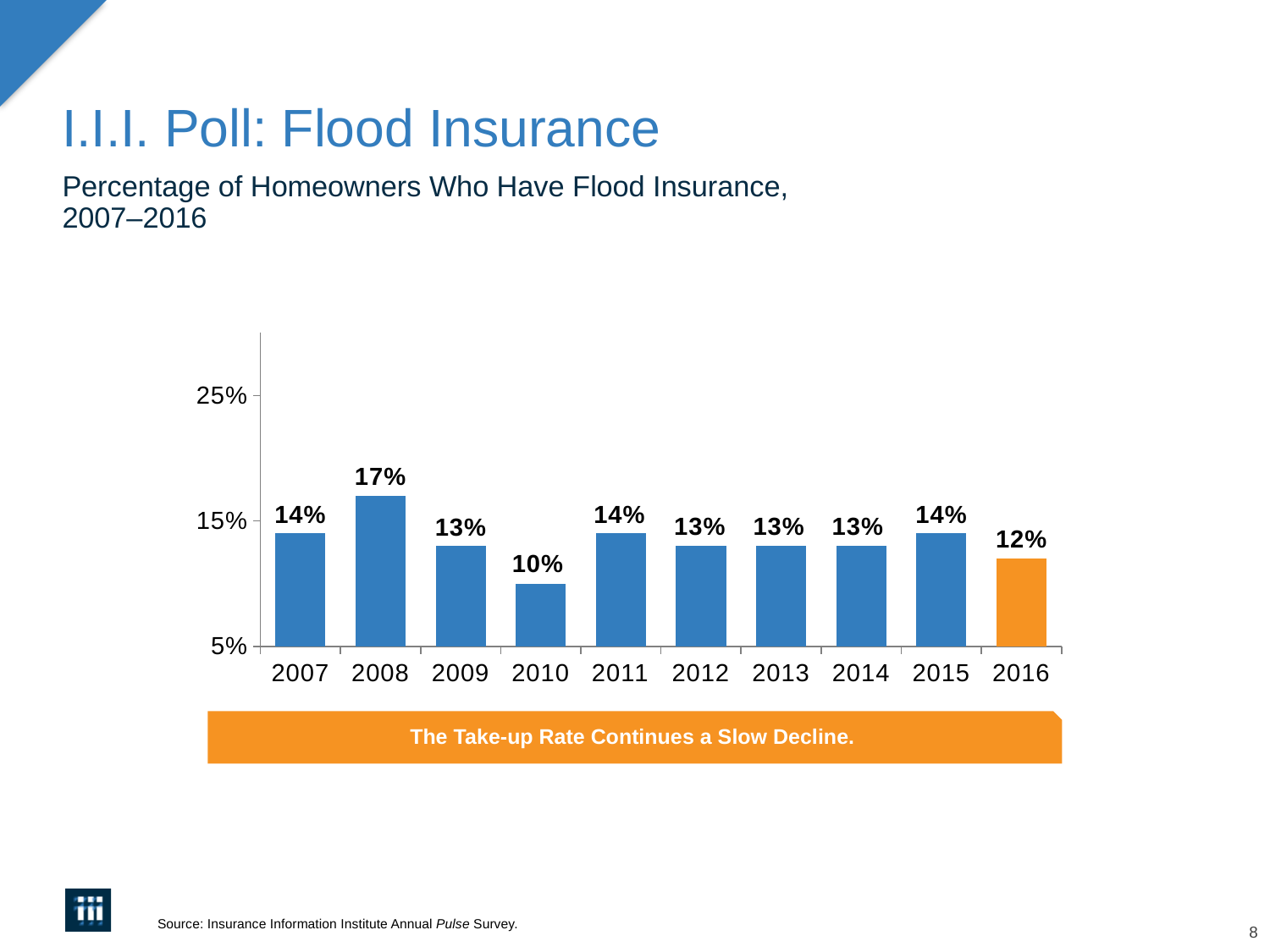
Which year has a larger value, 2008 or 2011? 2008 What percentage of homeowners had flood insurance in 2008? 17% Is the value for 2008 greater or less than 15%? greater Which year has the highest percentage of homeowners with flood insurance? 2008 What kind of chart is shown on the slide? Bar chart How many years are shown on the x axis? 10 What is the value shown for 2016? 12% What does the orange banner below the chart say? The Take-up Rate Continues a Slow Decline. What is the difference between the 2008 value and the 2016 value? 5% What percentage of homeowners had flood insurance in 2010? 10% What is the difference between the 2015 value and the 2010 value? 4% Which year has the lowest percentage of homeowners with flood insurance? 2010